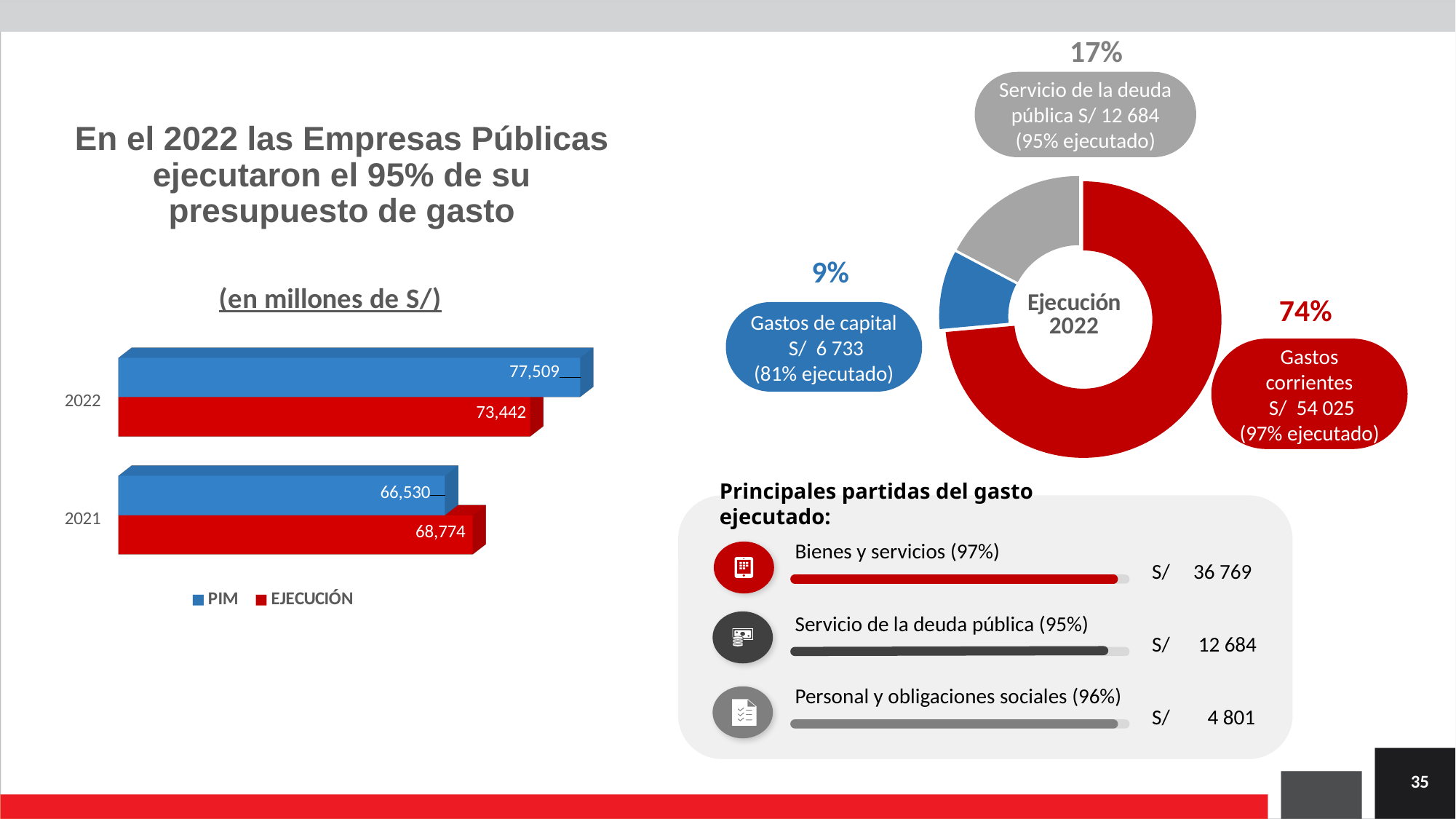
In the bar chart on the left, how many years are shown? 2 In the donut chart titled 'Ejecución 2022', what colour is the Gastos de capital slice? Blue In the donut chart titled 'Ejecución 2022', what share does Gastos corrientes represent? 74% What kind of chart is the chart on the left of the slide? Bar chart In the donut chart titled 'Ejecución 2022', which category has the smallest share? Gastos de capital In the bar chart on the left, which year has the highest PIM value? 2022 In the bar chart on the left, which is larger for 2021, PIM or EJECUCIÓN? EJECUCIÓN In the bar chart on the left, what is the difference between PIM and EJECUCIÓN for 2022? 4,067 In the bar chart on the left, what is the PIM value for 2022? 77,509 In the bar chart on the left, how many series does the legend list? 2 In the bar chart on the left, what is the EJECUCIÓN value for 2021? 68,774 In the donut chart titled 'Ejecución 2022', what is the amount for Servicio de la deuda pública? S/ 12 684